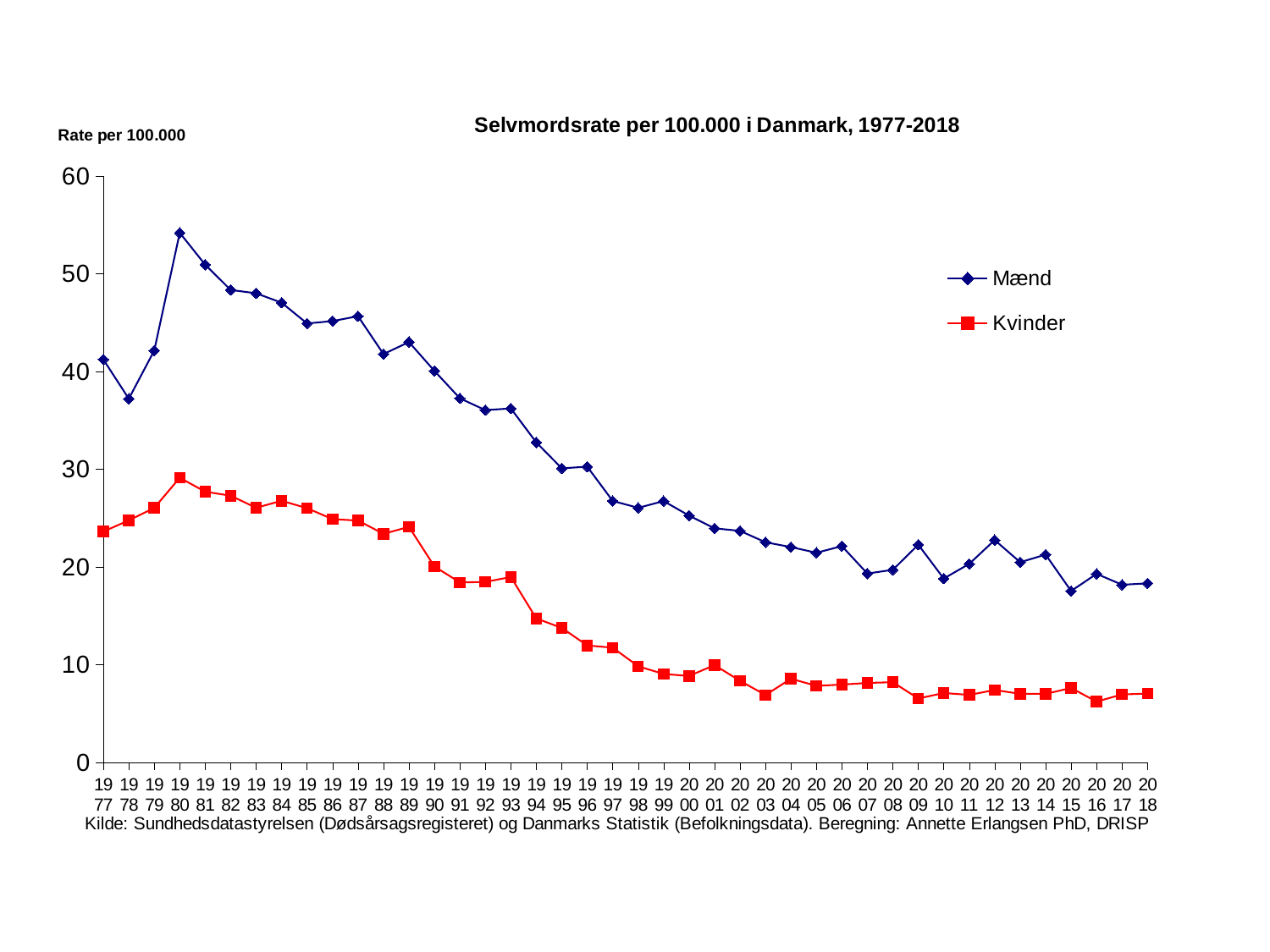
Is the value for Mænd in 2018 greater or less than 20? less Overall, do the values for Mænd rise or fall from 1980 to 2018? Fall In which year does the Kvinder series reach its highest value? 1980 What is the title of the chart? Selvmordsrate per 100.000 i Danmark, 1977-2018 How many years (data points) are plotted along the x axis? 42 Which series has the larger value in 2000, Mænd or Kvinder? Mænd Is the value for Mænd in 1980 greater or less than 50? greater What kind of chart is shown on the slide? Line chart Is the value for Mænd in 1978 greater or less than 40? less How many series does the legend list? 2 In which year does the Mænd series reach its highest value? 1980